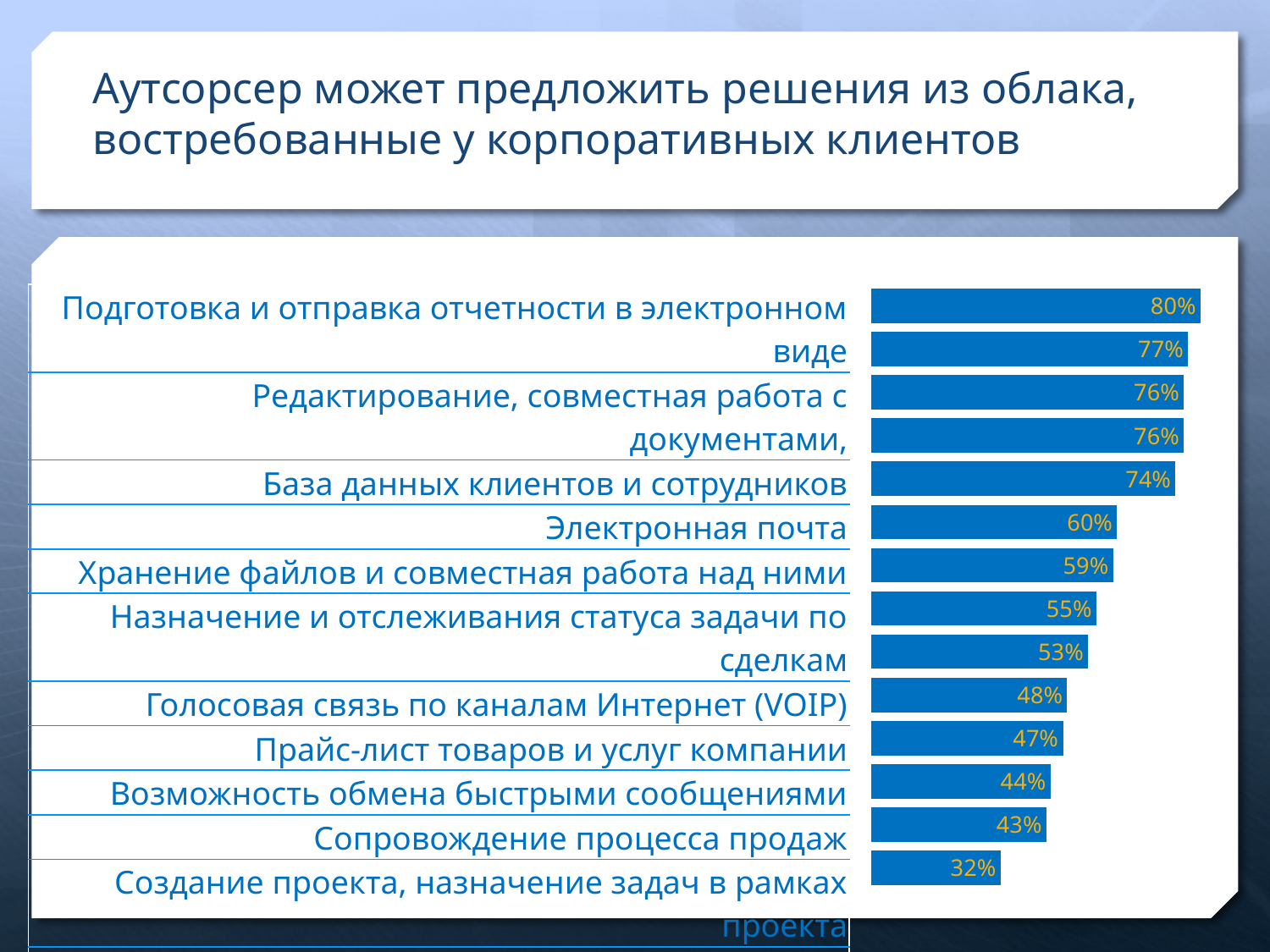
How many bars on the chart have a value of 76%? 2 Do the bar values increase or decrease going from the top of the chart to the bottom? Decrease How many bars does the chart contain? 14 What is the value of the second bar from the top? 77% How many bars on the chart have a value above 70%? 5 What colour are the bars on the chart? Blue Which is larger, the value of the top bar or the value of the bottom bar? The top bar What is the highest value shown on the chart? 80% What is the lowest value shown on the chart? 32% What is the difference between the highest value (80%) and the lowest value (32%) on the chart? 48 percentage points What kind of chart is shown on the slide? Bar chart What is the value of the second bar from the bottom? 43%